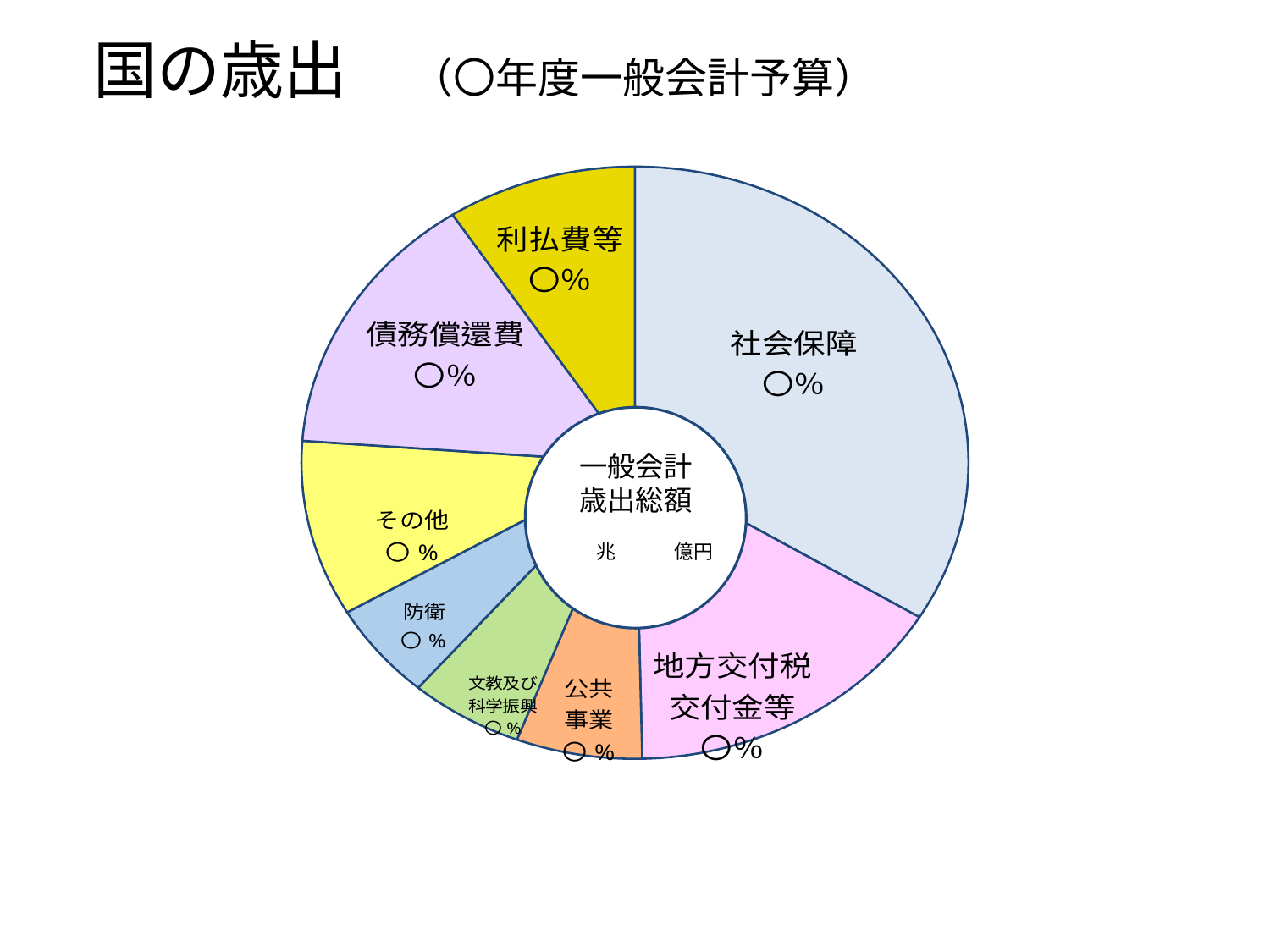
How many categories (slices) does the pie chart have? 8 What text is written in the centre of the pie chart (first two lines)? 一般会計 歳出総額 Which slice is larger, 社会保障 or 地方交付税交付金等? 社会保障 What kind of chart is shown on the slide? pie chart Which slice is larger, その他 or 防衛? その他 Which slice is larger, 債務償還費 or 利払費等? 債務償還費 Which category has the largest slice of the pie chart? 社会保障 What is the main title of the slide? 国の歳出